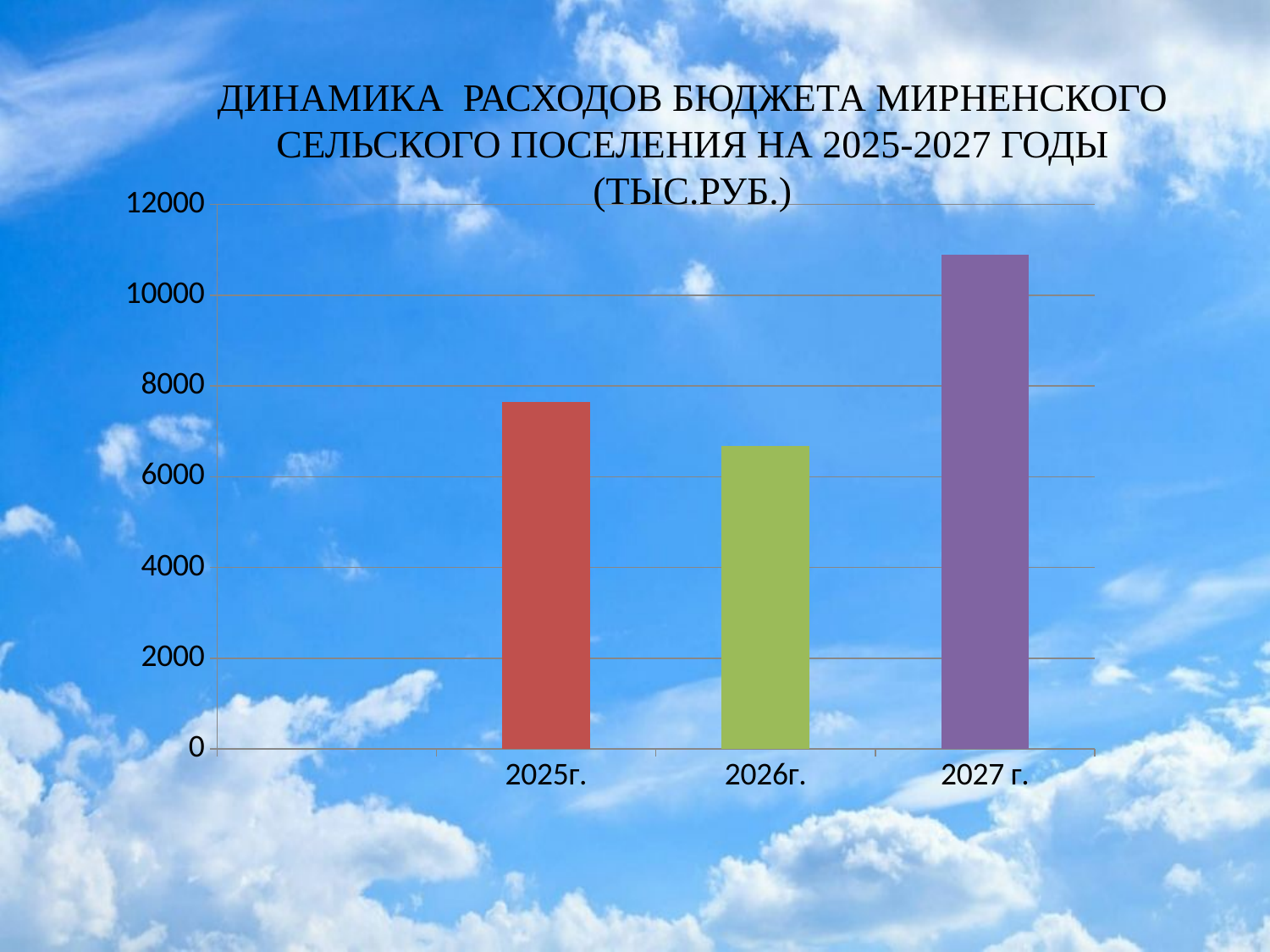
Which year has the highest budget expenditure in the chart? 2027 г. Does the value rise or fall from 2026г. to 2027 г.? rise Which is larger, the value for 2025г. or the value for 2026г.? 2025г. Is the value for 2027 г. greater or less than 10000? greater Is the value for 2025г. greater or less than 8000? less Which is larger, the value for 2026г. or the value for 2027 г.? 2027 г. Is the value for 2026г. greater or less than 6000? greater Which year has the lowest budget expenditure in the chart? 2026г. What kind of chart is shown on the slide? bar chart What is the maximum value shown on the vertical axis? 12000 What colour is the bar for 2027 г.? purple How many bars (years) are plotted in the chart? 3